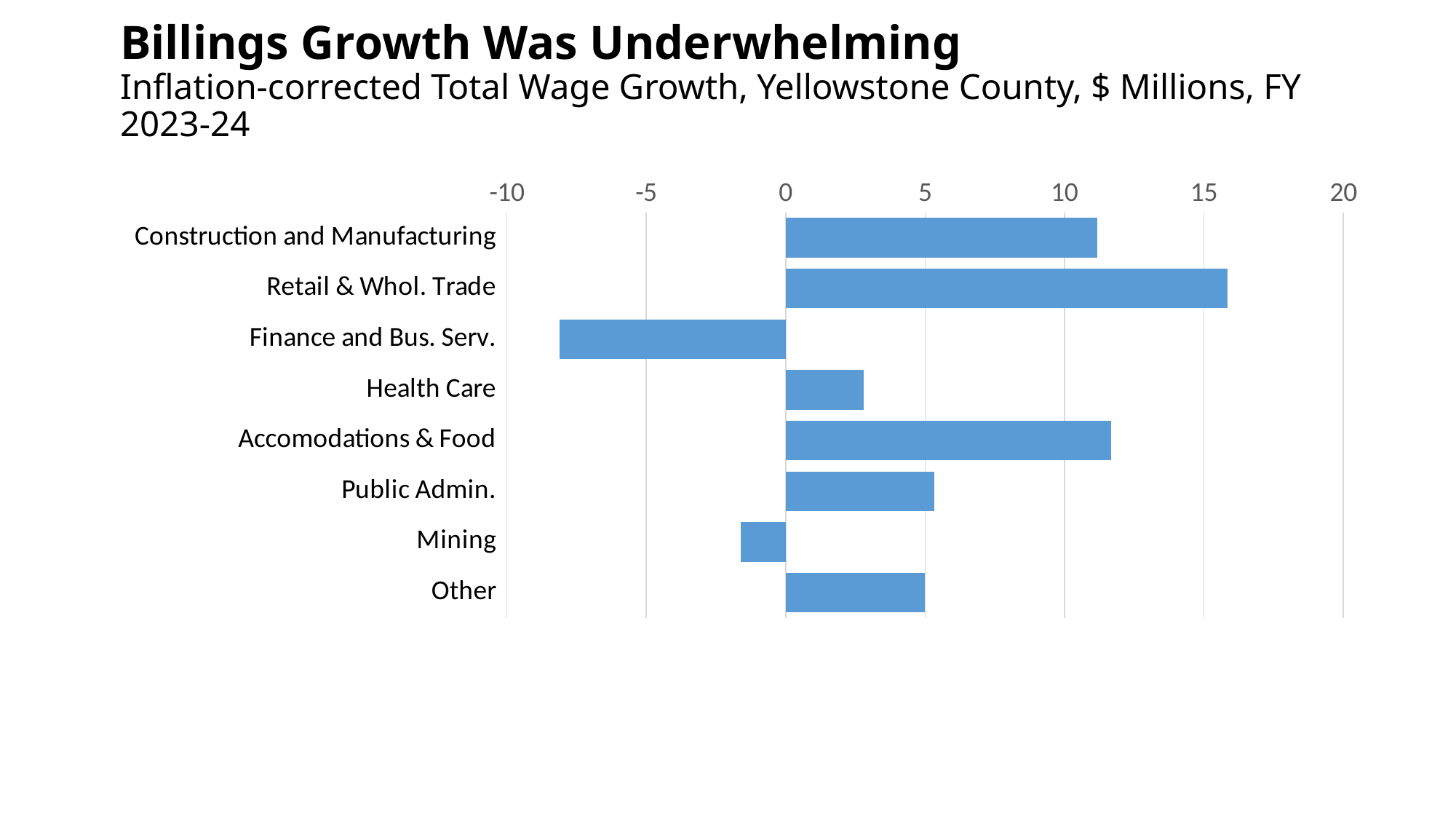
Which category has the lowest inflation-corrected wage growth? Finance and Bus. Serv. Is the value for Health Care greater or less than 5? less Which category has the highest inflation-corrected wage growth? Retail & Whol. Trade Is the value for Mining greater or less than 0? less Is the value for Retail & Whol. Trade greater or less than 15? greater How many categories show negative wage growth? 2 How many categories are plotted in the chart? 8 Which is larger, the value for Public Admin. or the value for Health Care? Public Admin. Which is larger, the value for Retail & Whol. Trade or the value for Construction and Manufacturing? Retail & Whol. Trade What kind of chart is shown on the slide? bar chart